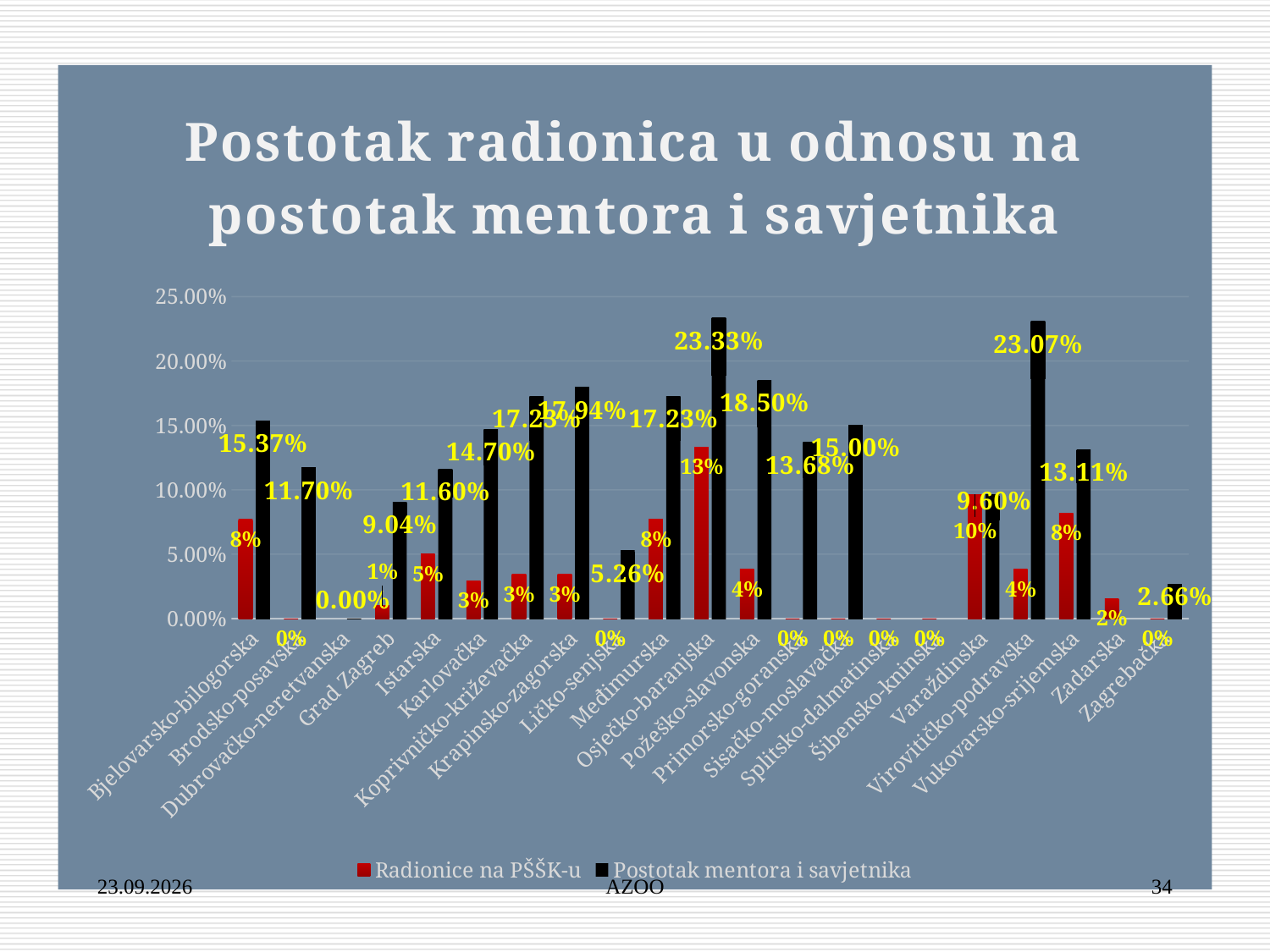
What is the value of 'Postotak mentora i savjetnika' for Osječko-baranjska? 23.33% For Varaždinska, which series has the larger value, 'Radionice na PŠŠK-u' or 'Postotak mentora i savjetnika'? Radionice na PŠŠK-u How many categories (counties) are shown on the x axis? 21 What are the two series named in the legend? Radionice na PŠŠK-u and Postotak mentora i savjetnika What is the value of 'Radionice na PŠŠK-u' for Varaždinska? 10% Which category has the highest value for 'Radionice na PŠŠK-u'? Osječko-baranjska What kind of chart is shown on the slide? bar chart Is the value of 'Postotak mentora i savjetnika' for Grad Zagreb greater or less than 10.00%? less What is the value of 'Postotak mentora i savjetnika' for Virovitičko-podravska? 23.07% How many series does the legend list? 2 What is the value of 'Postotak mentora i savjetnika' for Zagrebačka? 2.66%